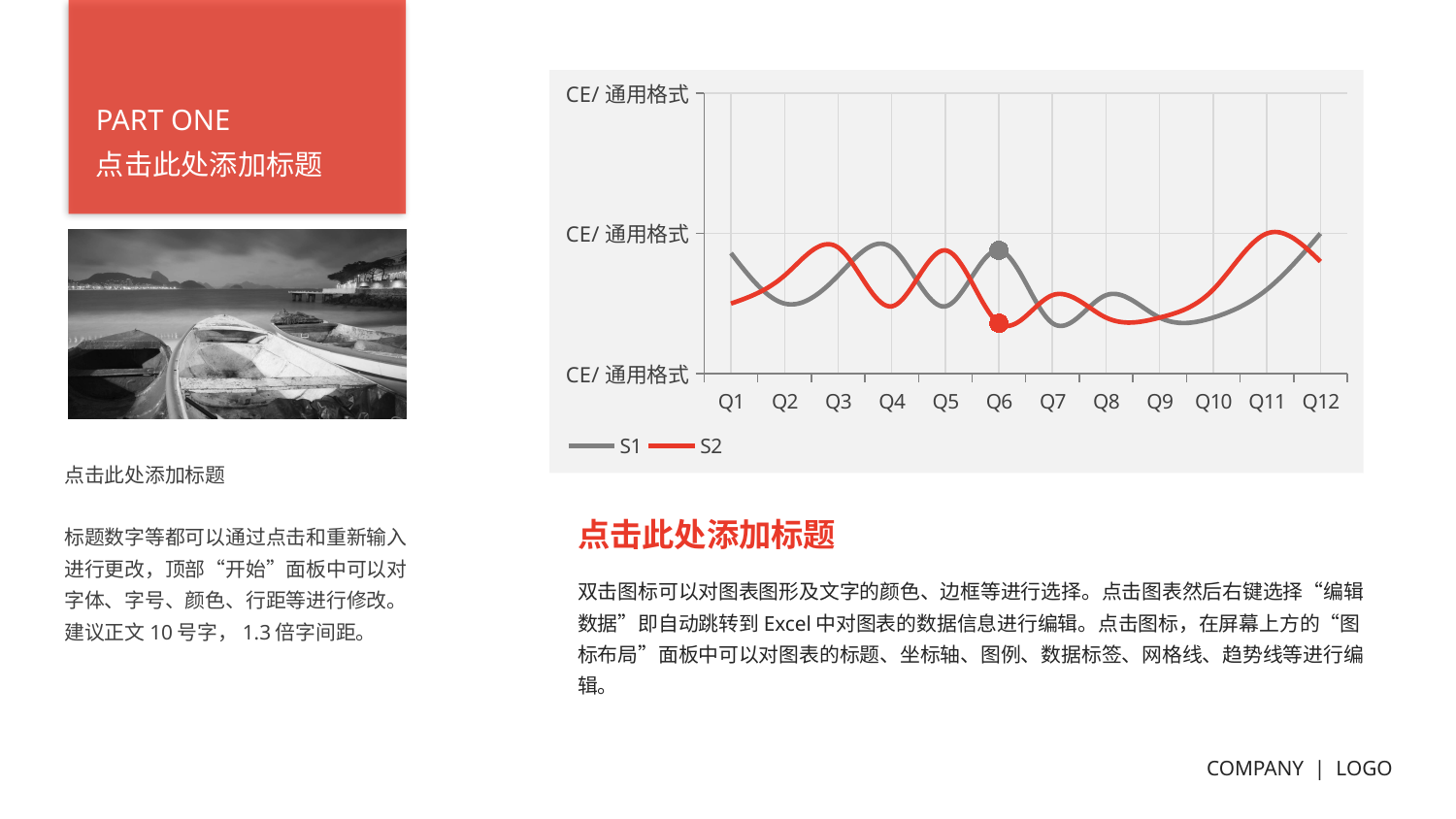
What kind of chart is shown on the slide? line chart At Q6, which series has the higher value, S1 or S2? S1 What are the names of the series in the chart's legend? S1 and S2 How many series does the chart's legend list? 2 At Q2, which series has the higher value, S1 or S2? S2 How many categories are shown on the x axis of the chart? 12 For series S1, does the value rise or fall from Q9 to Q12? rise At Q11, which series has the higher value, S1 or S2? S2 For series S2, which category has the highest value? Q11 Which colour is used for series S2 in the chart? red